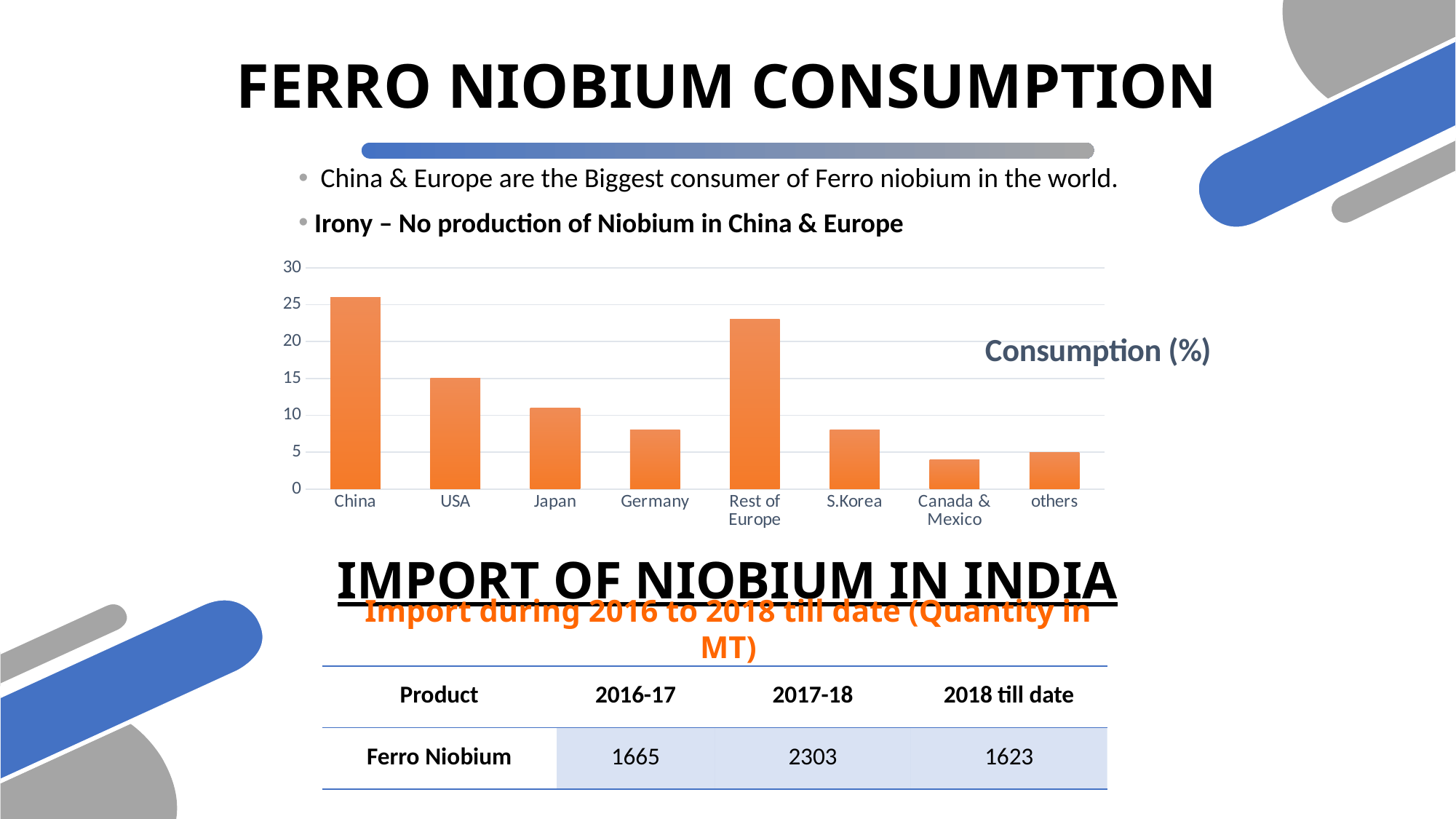
Is the value for China greater or less than 25? greater Which category has the lowest consumption in the chart? Canada & Mexico Which category has the highest consumption in the chart? China Which has a larger value, China or Rest of Europe? China How many categories are shown on the x axis of the chart? 8 Is the value for Rest of Europe greater or less than 20? greater What kind of chart is shown on the slide? bar chart Is the value for Canada & Mexico greater or less than 5? less Which has a larger value, Japan or Germany? Japan